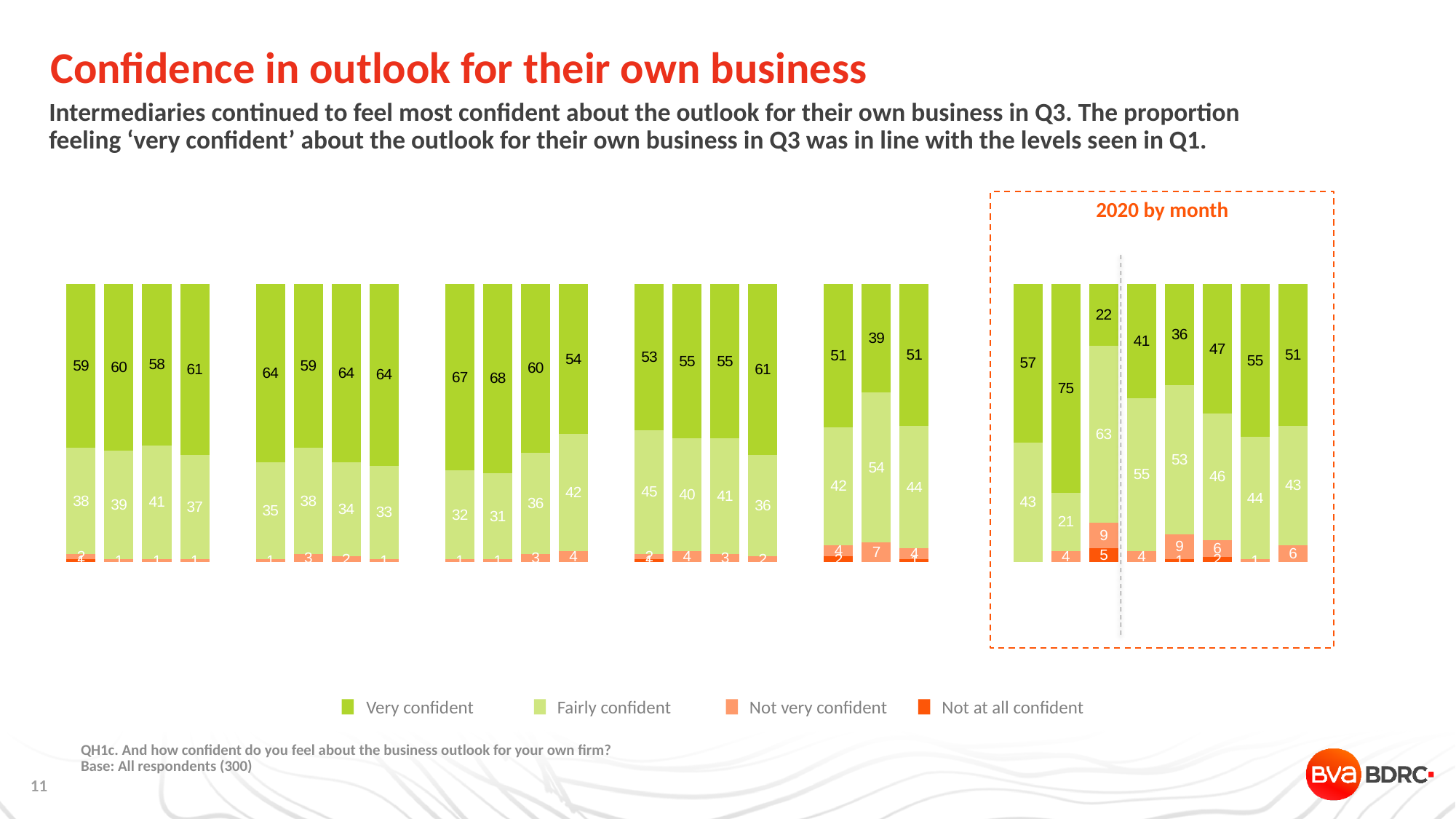
How many bars are inside the '2020 by month' box? 8 What is the highest 'Not very confident' value shown on the chart? 9 What is the label of the dashed box on the right of the chart? 2020 by month How many bars are plotted on the chart in total? 27 What is the difference between the highest and lowest 'Very confident' values on the chart? 53 How many series does the legend list? 4 What is the lowest 'Very confident' value shown on the chart? 22 What is the highest 'Fairly confident' value shown on the chart? 63 What is the lowest 'Fairly confident' value shown on the chart? 21 What kind of chart is shown on the slide? Stacked bar chart What are the four series named in the legend? Very confident, Fairly confident, Not very confident, Not at all confident What is the highest 'Very confident' value shown on the chart? 75